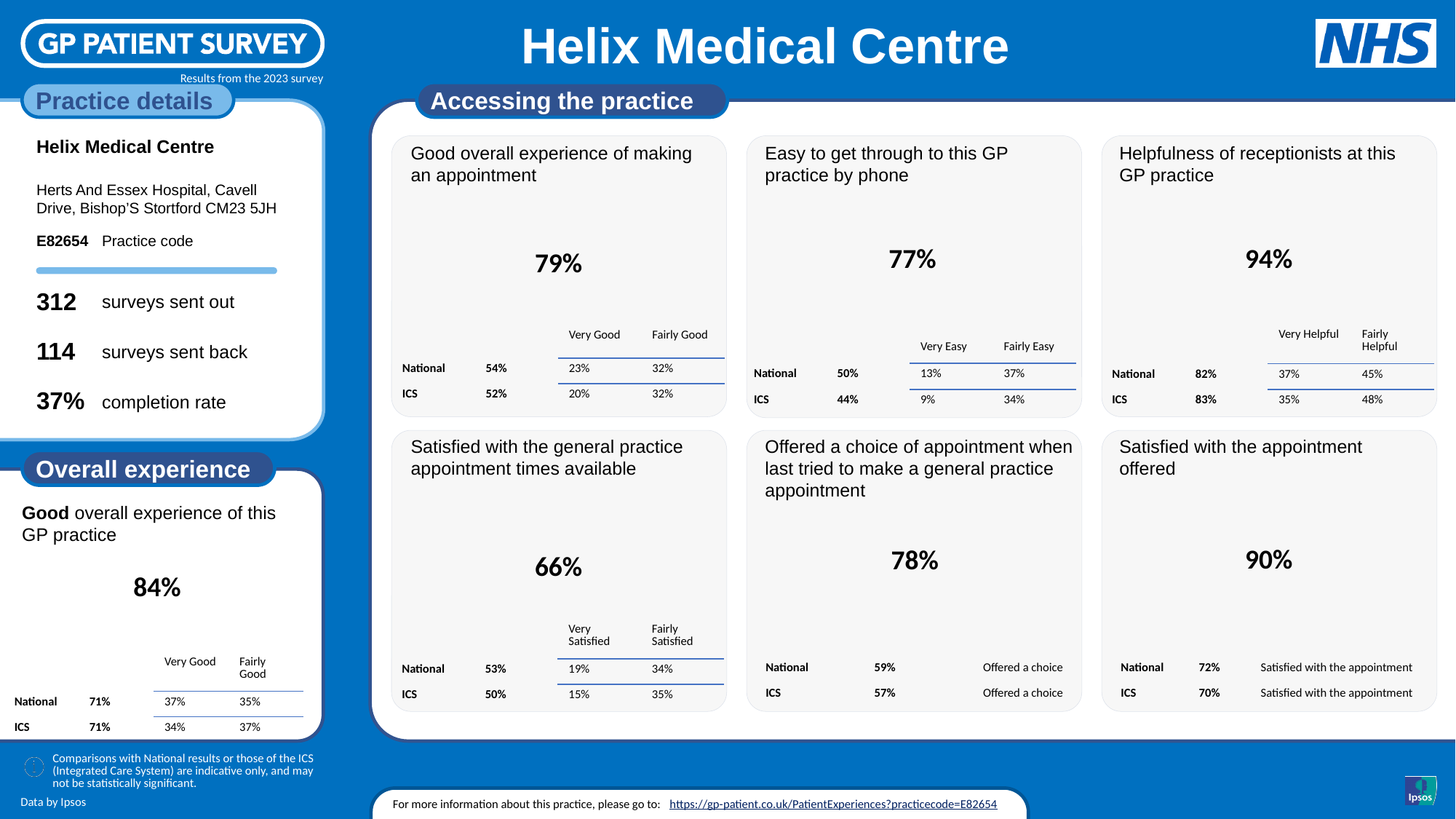
In the 'Satisfied with the general practice appointment times available' panel, what is the National value for Very Satisfied? 19% In the 'Easy to get through to this GP practice by phone' panel, what is the National value? 50% How many question panels are shown under the 'Accessing the practice' heading? 6 In the 'Good overall experience of making an appointment' panel, what is the practice's headline percentage? 79% In the 'Helpfulness of receptionists at this GP practice' panel, what is the ICS value for Fairly Helpful? 48% In the 'Offered a choice of appointment' panel, what is the ICS value? 57% Across the six 'Accessing the practice' panels, which question has the highest practice percentage? Helpfulness of receptionists at this GP practice In the 'Satisfied with the appointment offered' panel, what is the difference between the practice's 90% and the National 72%? 18% In the 'Overall experience' section, what is the difference between the National Very Good value (37%) and the ICS Very Good value (34%)? 3% In the 'Easy to get through to this GP practice by phone' panel, which is larger: the National value or the ICS value? National In the 'Overall experience' section, what is the practice's percentage for good overall experience of this GP practice? 84% Across the six 'Accessing the practice' panels, which question has the lowest practice percentage? Satisfied with the general practice appointment times available